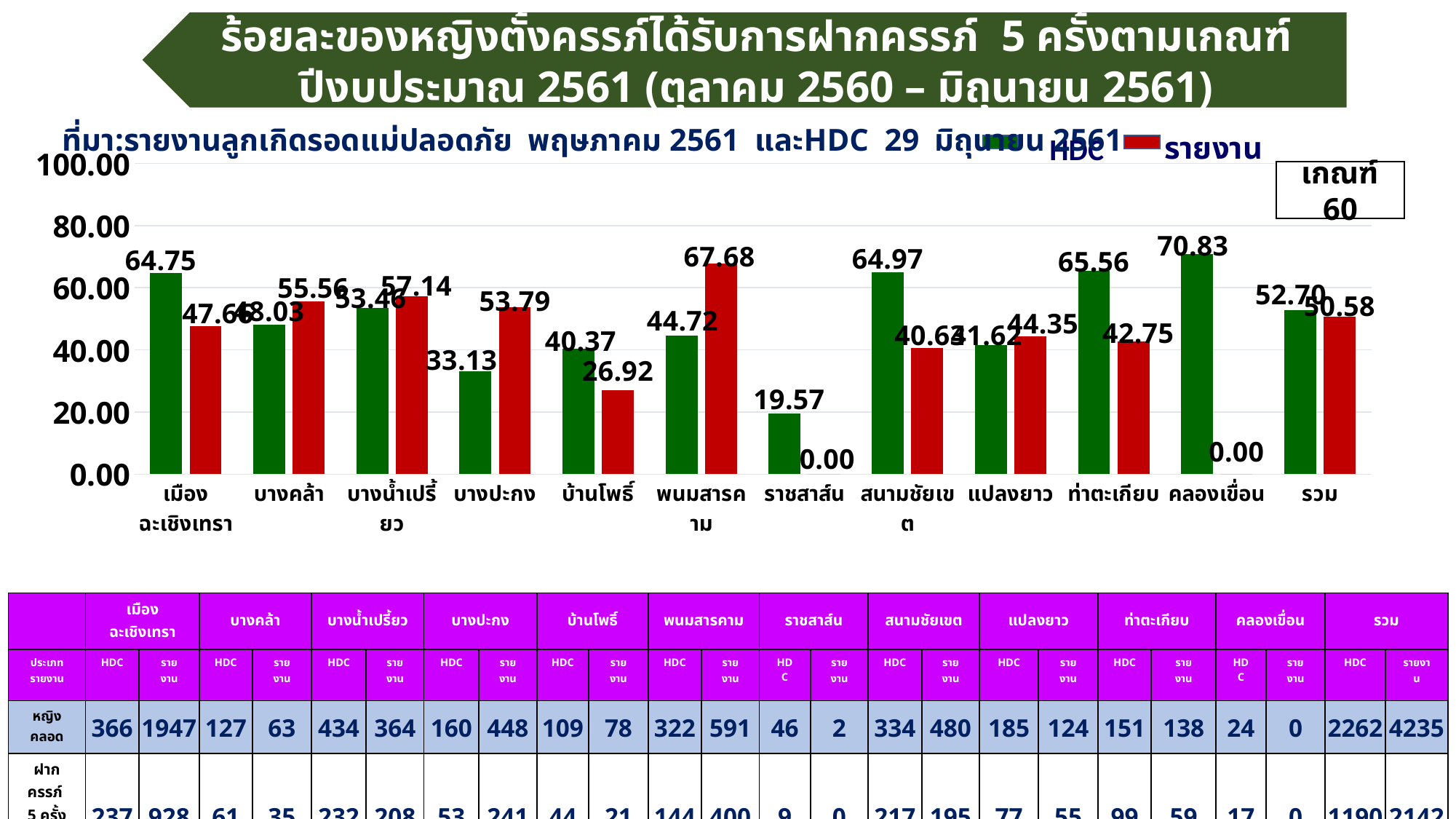
How many categories are shown on the x axis of the chart? 12 What is the รายงาน value for พนมสารคาม? 67.68 What is the HDC value for ราชสาส์น? 19.57 Which category has the highest รายงาน value? พนมสารคาม Which category has the lowest HDC value? ราชสาส์น For บ้านโพธิ์, which is larger, the HDC value or the รายงาน value? HDC What is the HDC value for คลองเขื่อน? 70.83 Which category has the highest HDC value? คลองเขื่อน What is the รายงาน value for รวม? 50.58 What kind of chart is shown on the slide? bar chart What is the difference between the HDC and รายงาน values for บางปะกง? 20.66 How many series does the chart legend list? 2